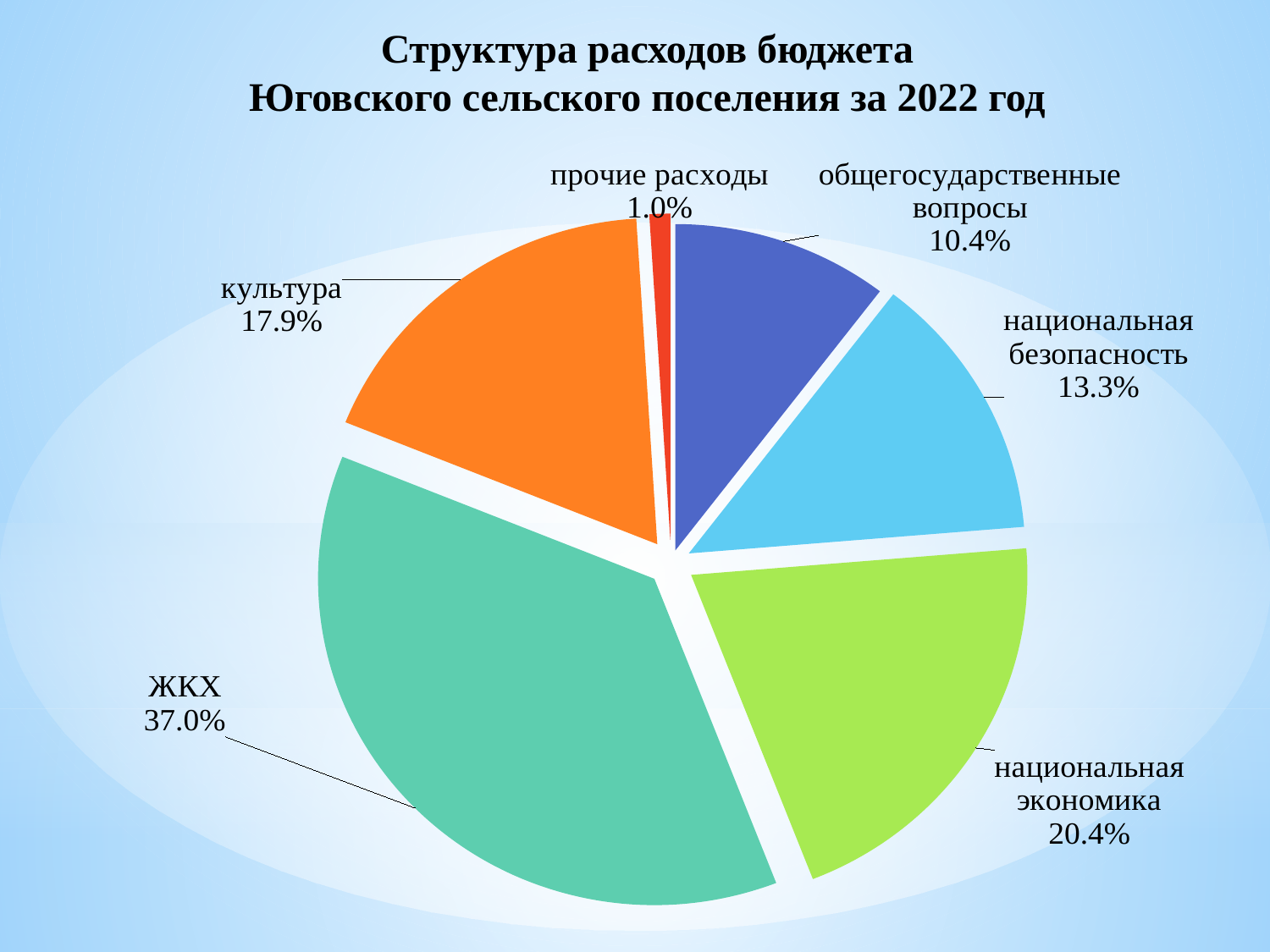
What share of budget expenditure does ЖКХ account for? 37.0% Which category has the largest slice of the pie? ЖКХ What type of chart is shown on the slide? pie chart What share is shown for общегосударственные вопросы? 10.4% What is the difference between the shares of ЖКХ and национальная экономика? 16.6% What percentage is shown for культура? 17.9% Which category has the smallest slice of the pie? прочие расходы How many categories are shown in the pie chart? 6 What is the value for национальная безопасность? 13.3% What is the title of the chart? Структура расходов бюджета Юговского сельского поселения за 2022 год What is the value shown for национальная экономика? 20.4% Which is larger: культура or национальная безопасность? культура